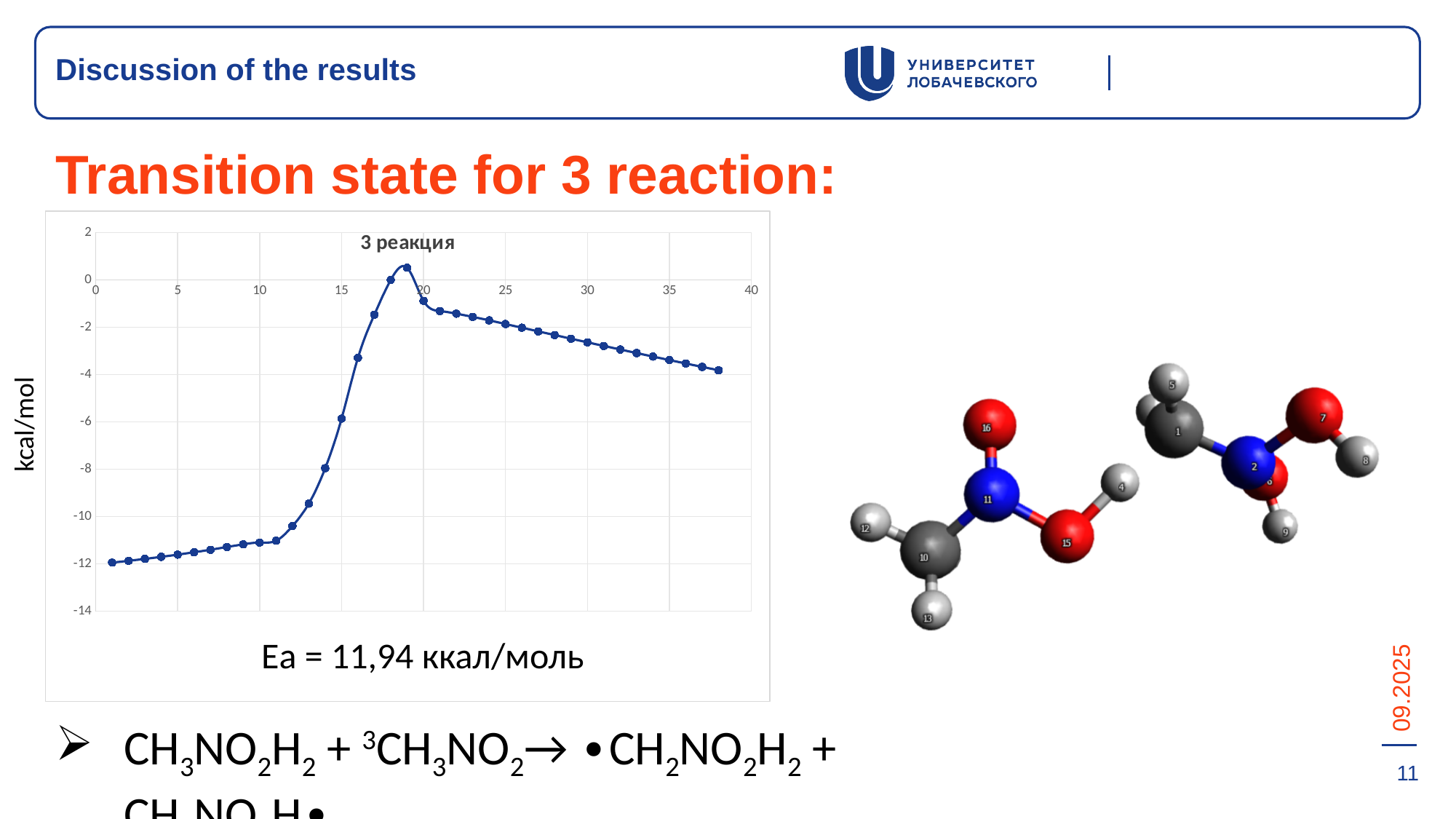
Do the values rise or fall along the x axis between x = 20 and x = 38? fall Is the value at x = 1 greater or less than -10? less What activation energy (Ea) is printed below the chart? Ea = 11,94 ккал/моль What is the label on the y axis of the chart? kcal/mol Is the peak value of the curve greater or less than 0? greater What is the title of the chart? 3 реакция Is the value at x = 10 greater or less than -10? less What kind of chart is shown on the slide? Line chart Do the values rise or fall along the x axis between x = 1 and x = 19? rise Which is larger, the value at x = 5 or the value at x = 35? x = 35